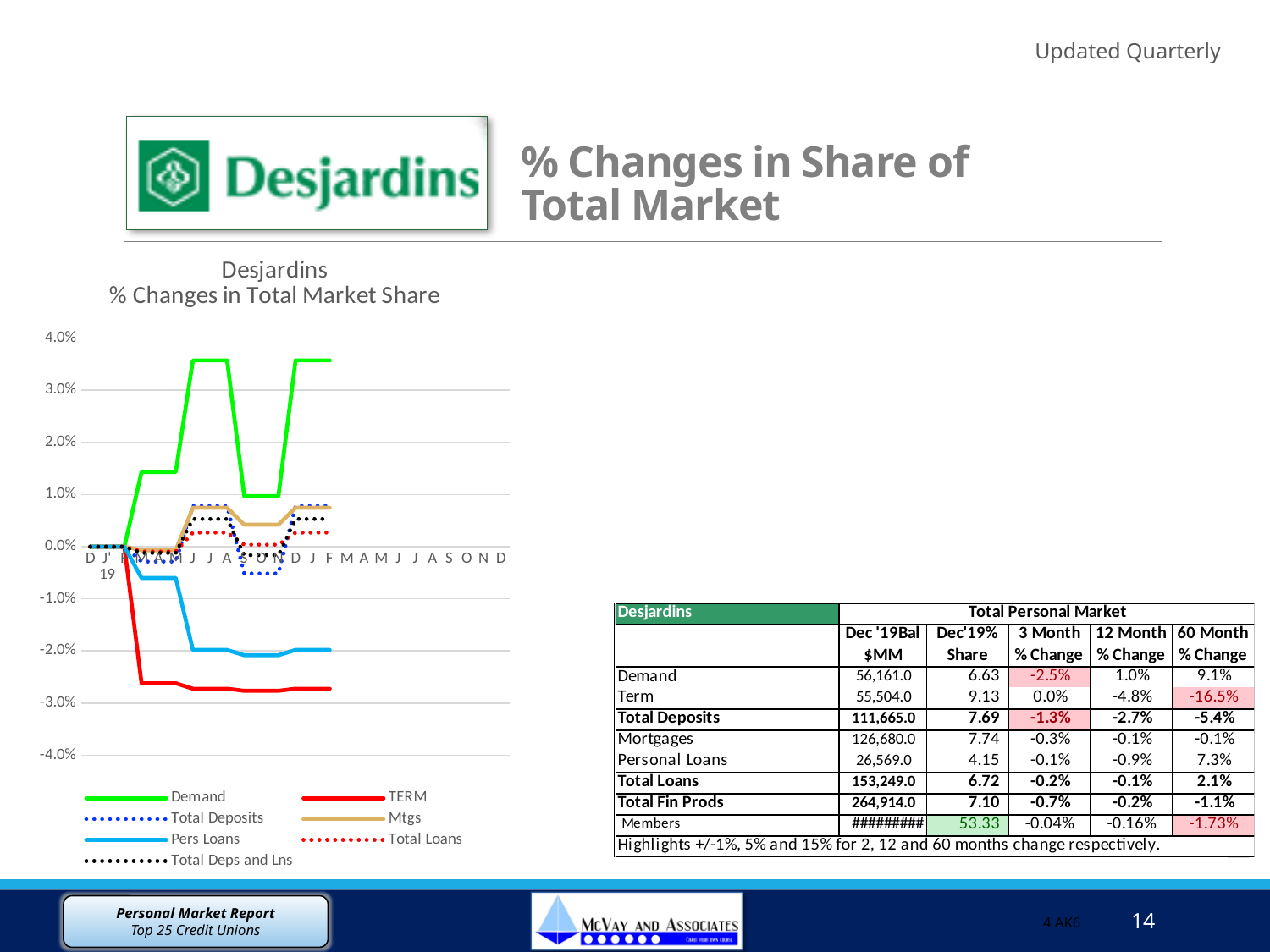
Does the TERM line overall rise or fall from the start to the end of the chart? fall How many series does the chart legend list? 7 What is the title of the chart? Desjardins % Changes in Total Market Share Is the value of the Demand line at the final month greater or less than 2.0%? greater What kind of chart is shown on the slide? line chart Which series has the lowest value at the end of the chart? TERM At the end of the chart, which is higher, the Demand line or the TERM line? Demand Is the lowest value reached by the TERM line greater or less than -2.0%? less Which series has the highest value at the end of the chart? Demand Is the highest value reached by the Demand line greater or less than 3.0%? greater What colour is the Demand line in the chart? green